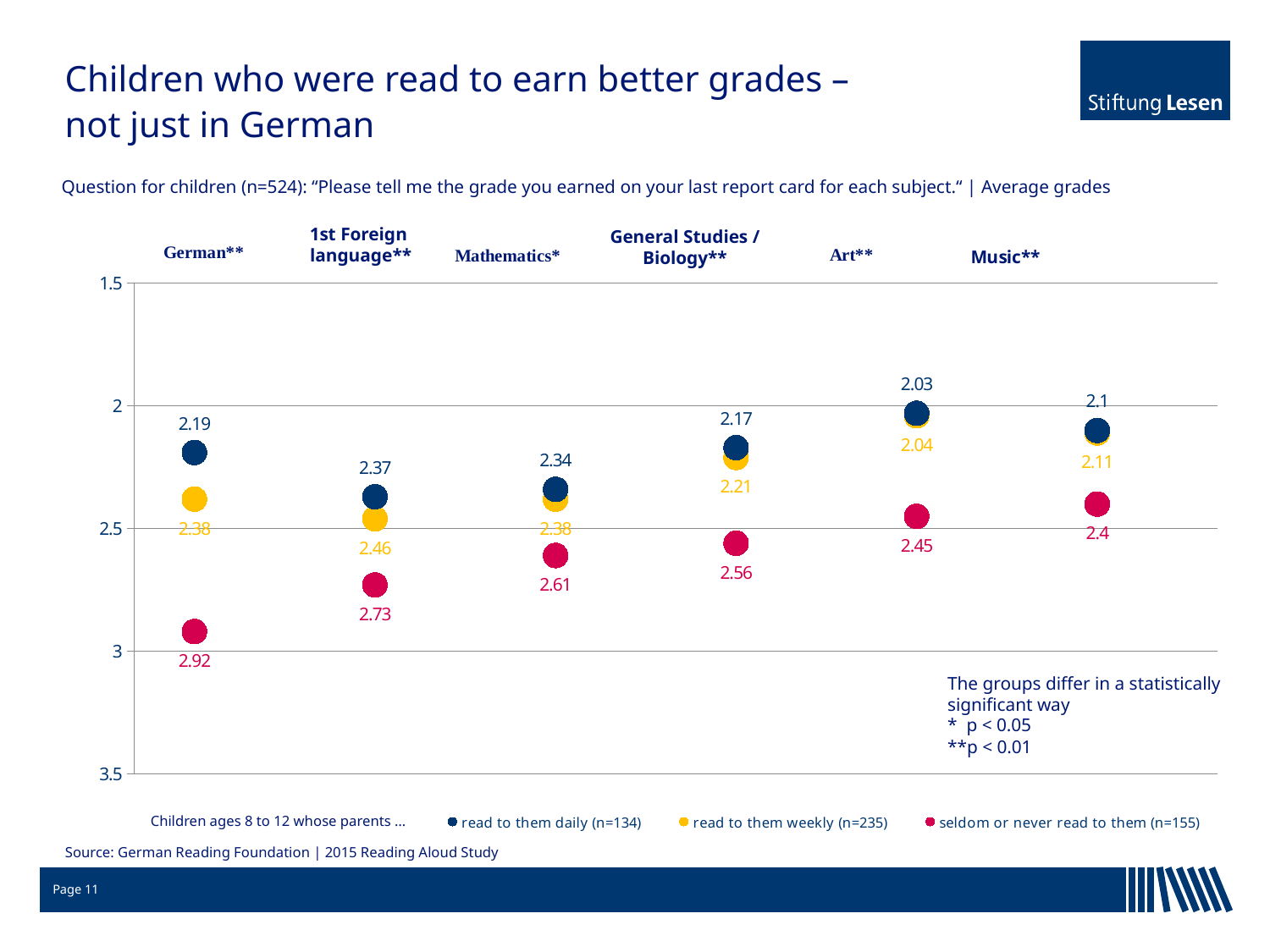
How many subjects are shown on the chart? 6 What kind of chart is shown on the slide? dot (scatter) chart What is the average grade in German for children who are read to daily? 2.19 For which subject is the average grade of children who are seldom or never read to numerically the largest? German Which colour represents children whose parents seldom or never read to them? red How many series does the legend list? 3 What is the average grade in Mathematics for children who are seldom or never read to? 2.61 In 1st Foreign language, which group has the numerically larger average grade: children read to weekly or children seldom or never read to? seldom or never read to What is the difference between the German grades of children seldom or never read to (2.92) and children read to daily (2.19)? 0.73 What is the average grade in Music for children who are seldom or never read to? 2.4 For which subject is the average grade of children who are read to daily numerically the smallest? Art What is the average grade in Art for children who are read to weekly? 2.04